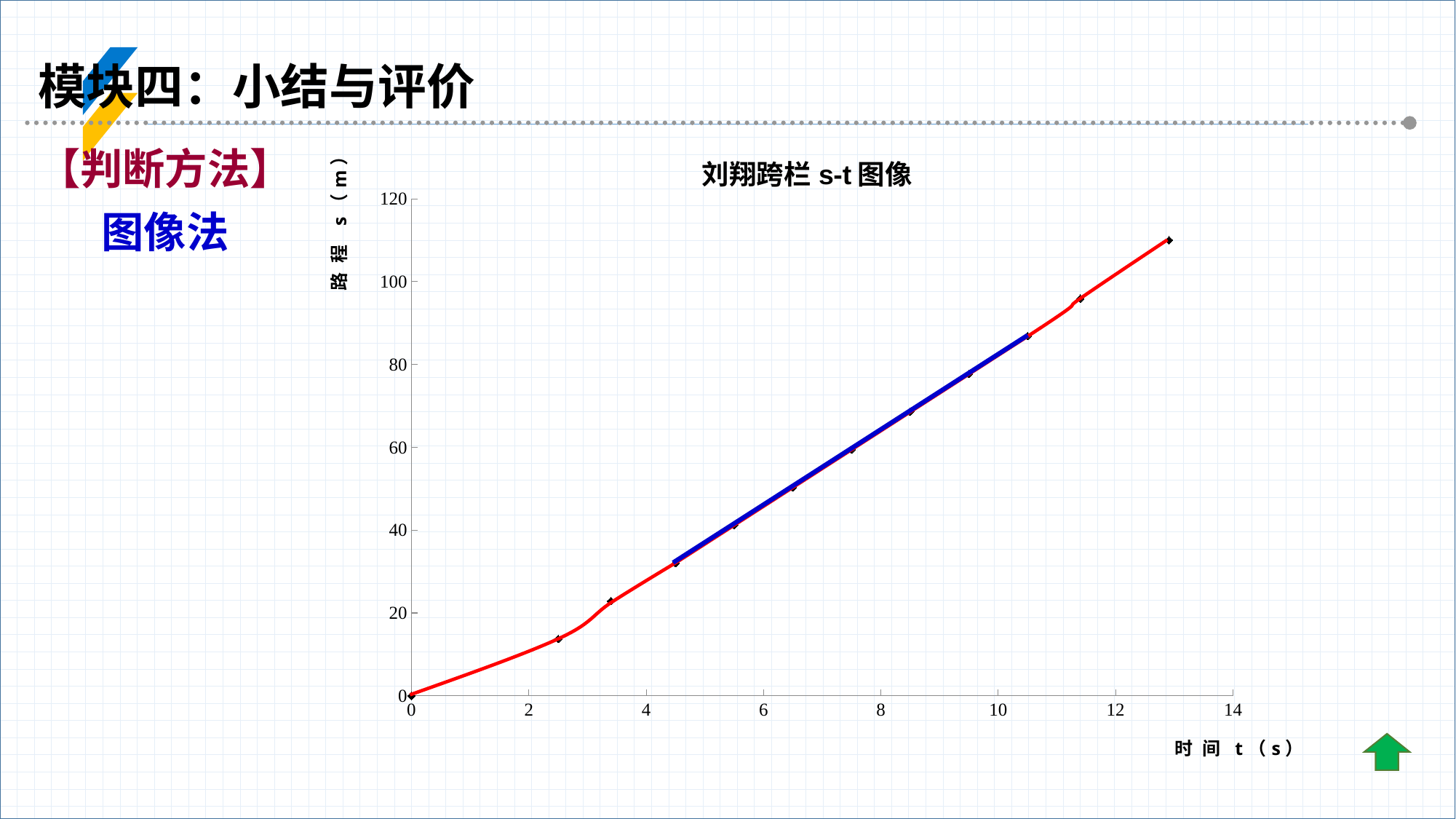
What is the label of the x axis? 时间 t（s） How many data points are plotted on the line? 12 What is the value of s at t = 0? 0 At which end of the time axis is the distance s largest, t = 0 or t = 12? t = 12 Is the value of s at t = 8 greater or less than 60? greater Is the value of s at t = 4 greater or less than 40? less What is the title of the chart? 刘翔跨栏 s-t 图像 Does the distance s rise or fall as time t increases? rise What kind of chart is shown on the slide? line chart What is the highest tick value shown on the y axis? 120 Is the value of s at t = 6 greater or less than 40? greater